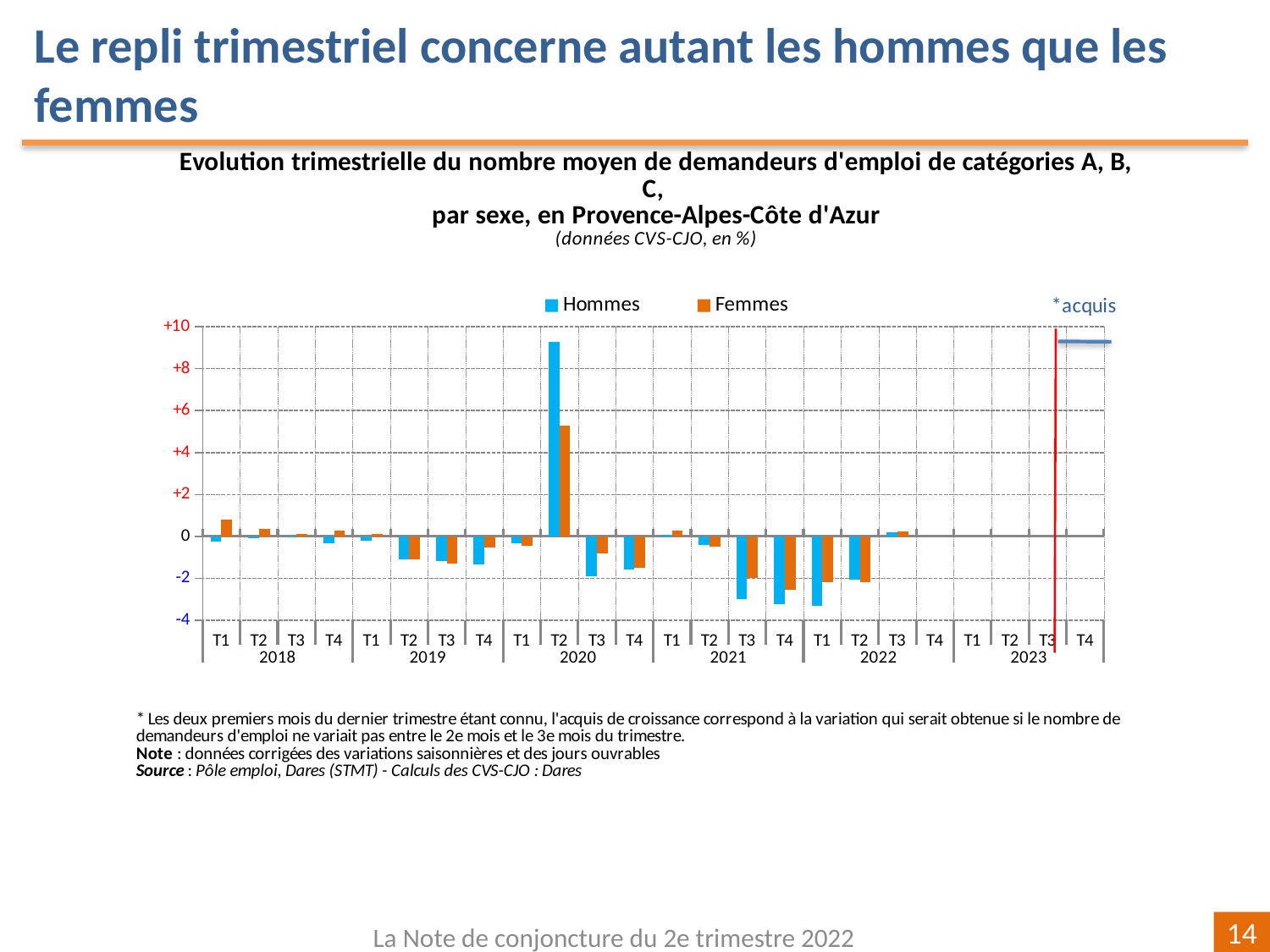
In which quarter does the Femmes series reach its lowest value? T4 2021 Is the value for Femmes in T2 2020 greater or less than +6? less Which series is shown in orange? Femmes In T1 2018, which series has the larger value, Hommes or Femmes? Femmes Is the value for Hommes in T3 2021 greater or less than -2? less Is the value for Hommes in T2 2020 greater or less than +8? greater In which quarter does the Hommes series reach its highest value? T2 2020 How many series does the legend list? 2 In which quarter does the Femmes series reach its highest value? T2 2020 What region does the chart title say the data covers? Provence-Alpes-Côte d'Azur What kind of chart is shown on the slide? bar chart In T2 2020, which series has the larger value, Hommes or Femmes? Hommes